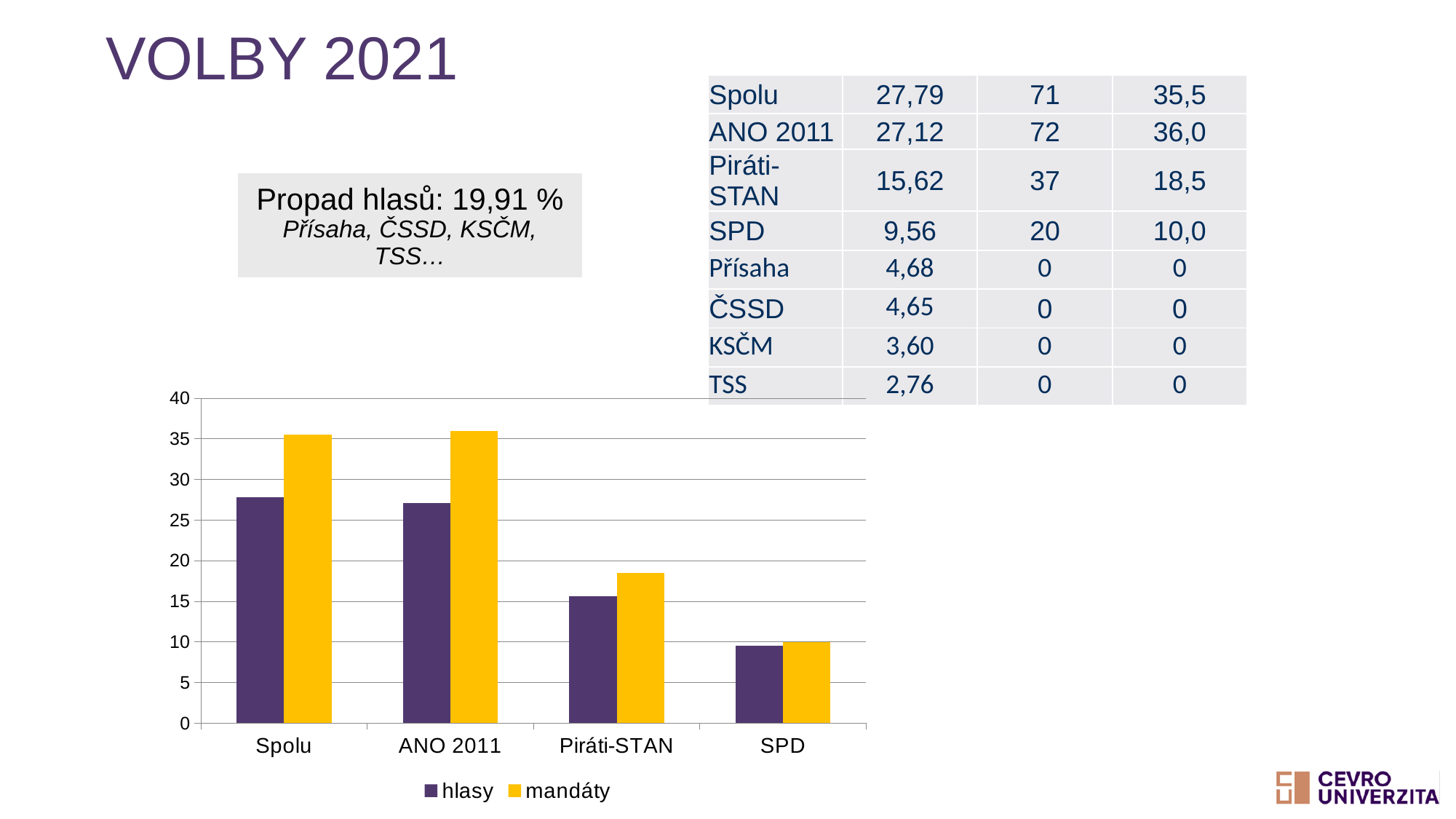
How many series does the chart legend list? 2 Do the hlasy values rise or fall from left to right along the x axis? fall For Piráti-STAN, which is larger: hlasy or mandáty? mandáty Is the hlasy value for Piráti-STAN greater or less than 10? greater What colour are the mandáty bars in the chart? yellow Is the mandáty value for ANO 2011 greater or less than 30? greater Is the mandáty value for Piráti-STAN greater or less than 20? less What kind of chart is shown on the slide? bar chart How many categories are shown on the x axis of the chart? 4 Which category has the lowest value for mandáty? SPD Which category has the lowest value for hlasy? SPD